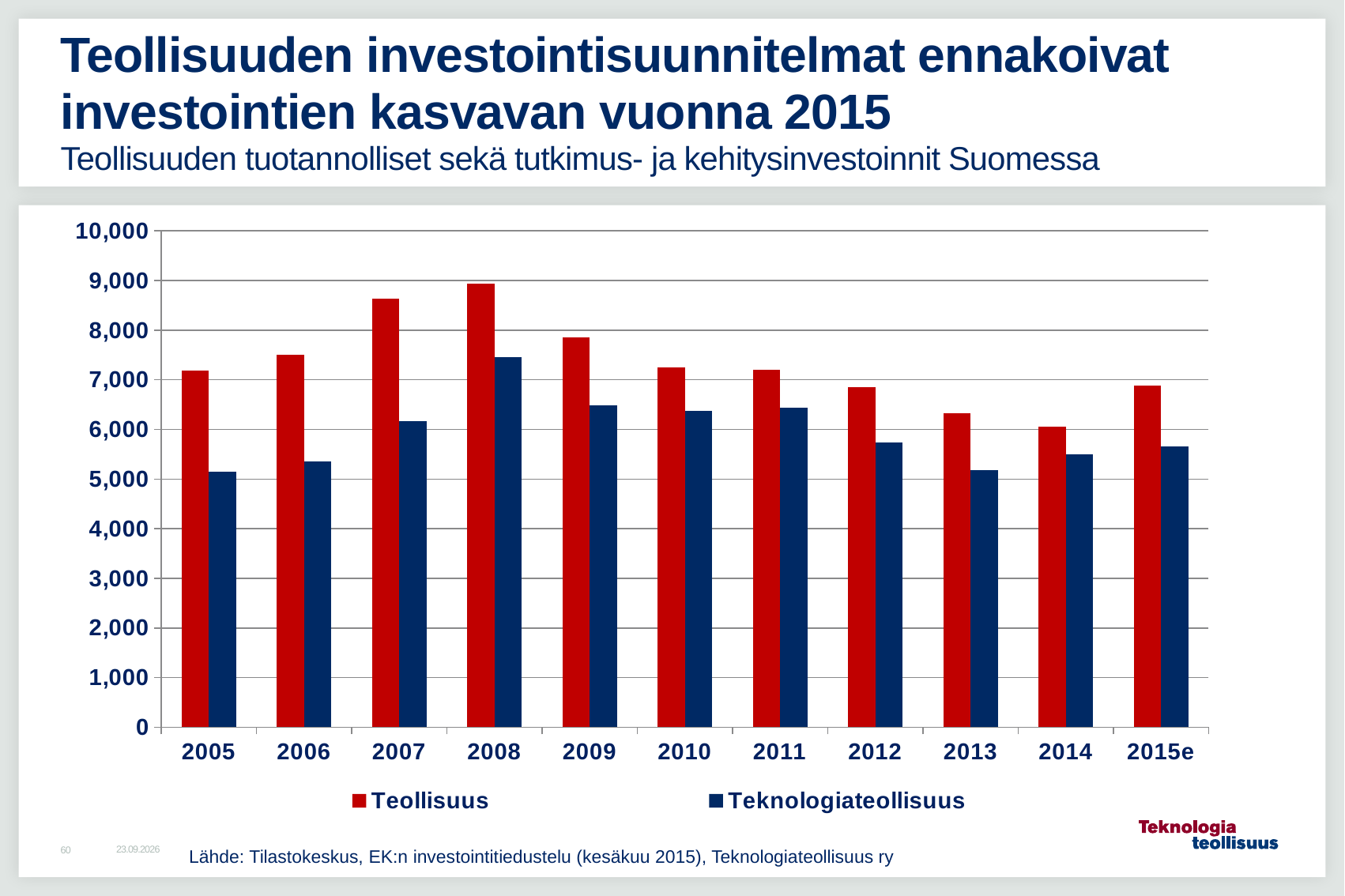
Is the Teollisuus value for 2008 greater or less than 8,000? greater Which colour represents the Teknologiateollisuus series? dark blue In which year is the Teknologiateollisuus value highest? 2008 Is the Teknologiateollisuus value for 2008 greater or less than 7,000? greater Does the Teollisuus value rise or fall from 2008 to 2014? fall In which year is the Teollisuus value lowest? 2014 Is the Teknologiateollisuus value for 2012 greater or less than 6,000? less Which is larger, the Teollisuus value for 2006 or for 2005? 2006 How many series does the legend list? 2 What kind of chart is shown on the slide? bar chart How many years are shown on the x axis? 11 In which year is the Teollisuus value highest? 2008